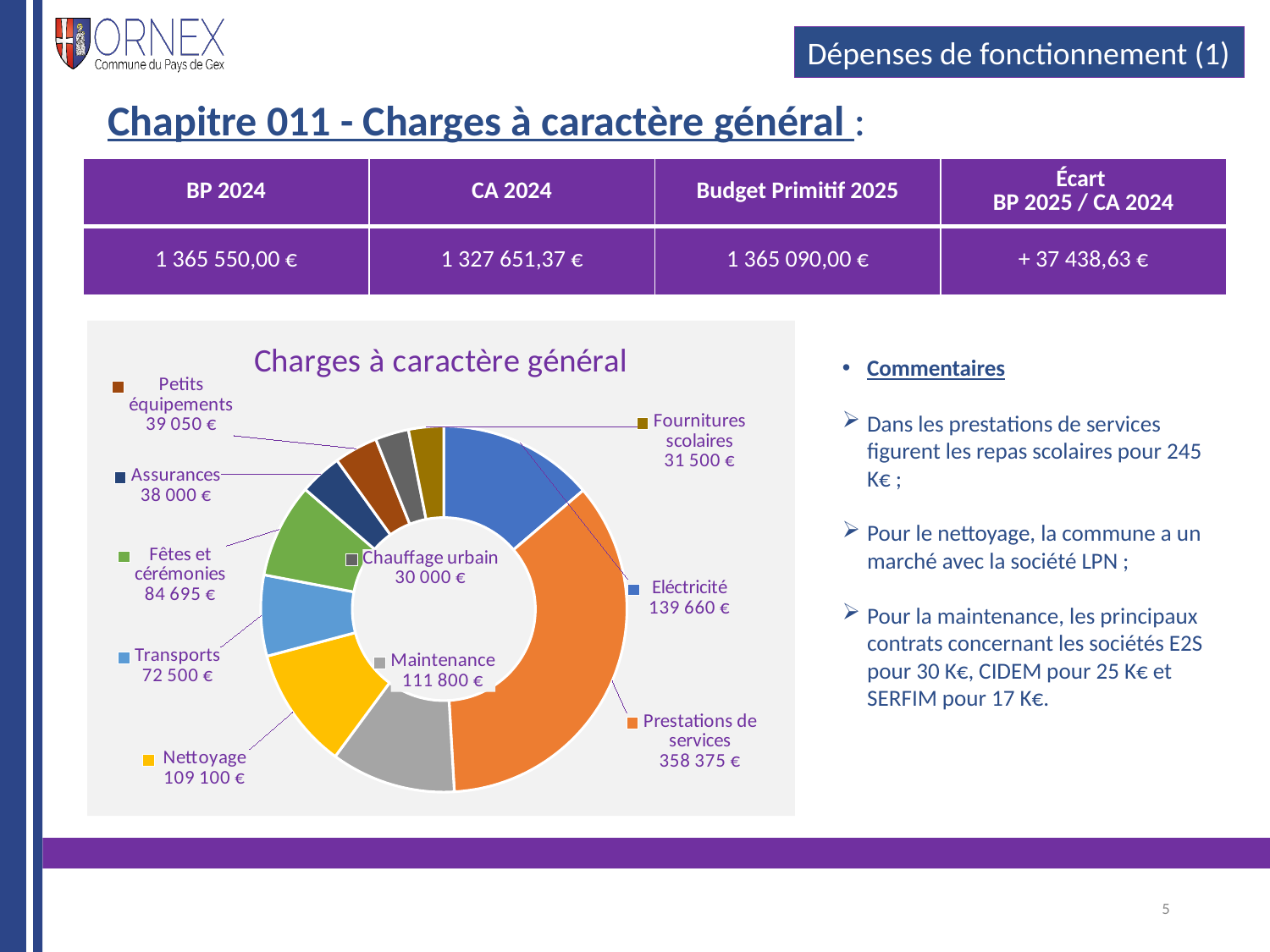
What is the difference between Petits équipements and Assurances in the chart? 1 050 € What is the value for Nettoyage in the chart? 109 100 € Which category has the lowest value in the chart? Chauffage urbain What kind of chart is used to show the Charges à caractère général? doughnut chart What is the value for Prestations de services in the Charges à caractère général chart? 358 375 € What is the difference between Eléctricité and Maintenance in the chart? 27 860 € What is the title of the chart on the slide? Charges à caractère général Which category has the highest value in the Charges à caractère général chart? Prestations de services What is the value for Eléctricité in the chart? 139 660 € How many categories are shown in the Charges à caractère général chart? 10 What is the value for Chauffage urbain in the chart? 30 000 € Which is larger in the chart, Fêtes et cérémonies or Transports? Fêtes et cérémonies